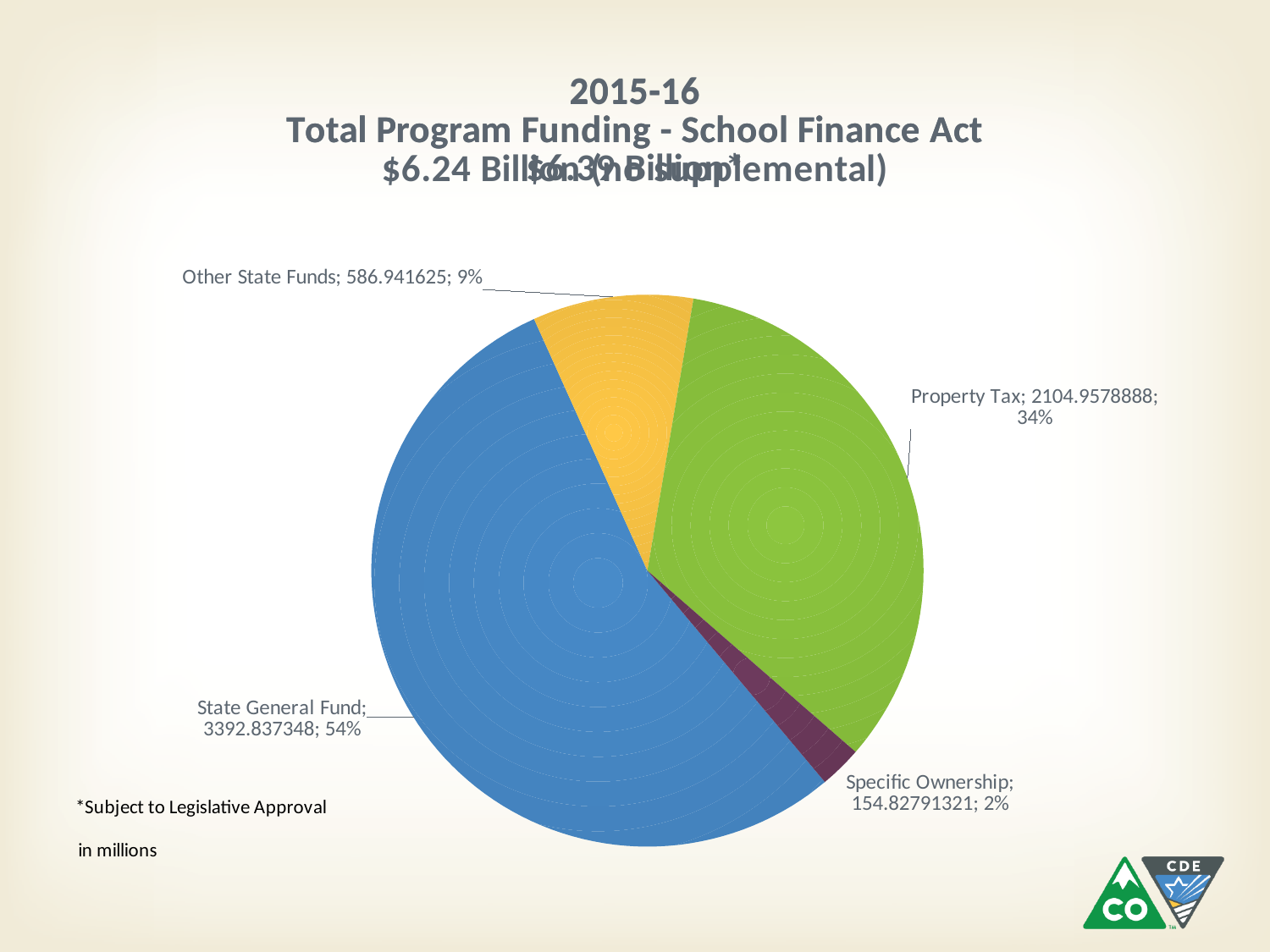
What share of the pie does State General Fund represent? 54% Which category has the largest slice of the pie? State General Fund What is the value shown for Property Tax? 2104.9578888 Which is larger, the value for Property Tax or the value for Other State Funds? Property Tax What is the value shown for Specific Ownership? 154.82791321 What kind of chart is shown on the slide? pie chart What colour is the State General Fund slice? blue What is the value shown for State General Fund? 3392.837348 What share of the pie does Property Tax represent? 34% How many slices does the pie chart have? 4 Which category has the smallest slice of the pie? Specific Ownership What is the value shown for Other State Funds? 586.941625